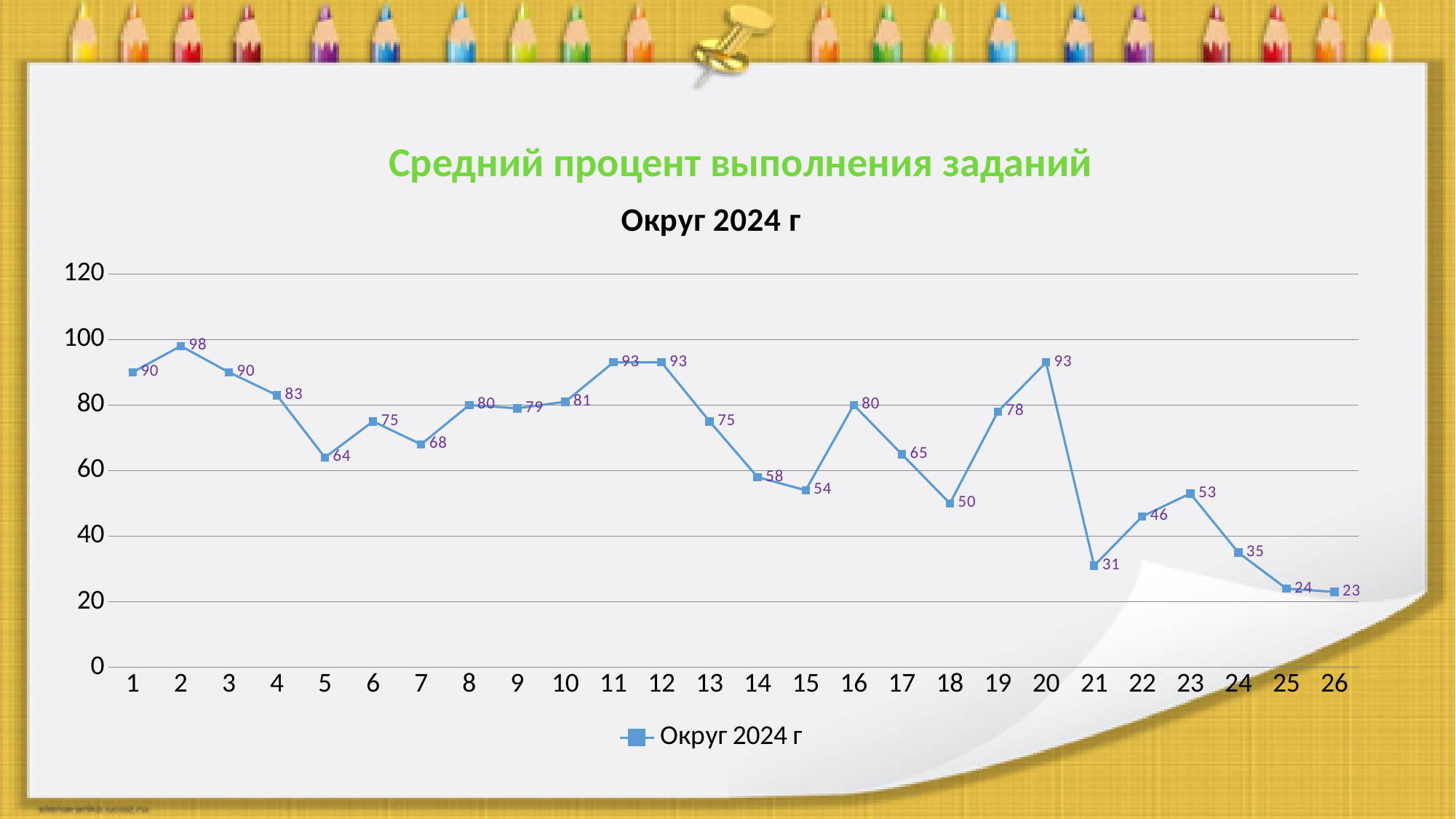
Which task has the highest value? 2 What is the title of the chart? Округ 2024 г Do the values generally rise or fall from task 20 to task 26? Fall How many series does the legend list? 1 How many tasks (points) are plotted on the x axis? 26 What is the difference between the values for task 20 and task 21? 62 Which task has the lowest value? 26 What is the value for task 21? 31 What is the value for task 16? 80 What type of chart is shown on the slide? Line chart What is the value for task 2? 98 Which has a larger value, task 5 or task 7? Task 7